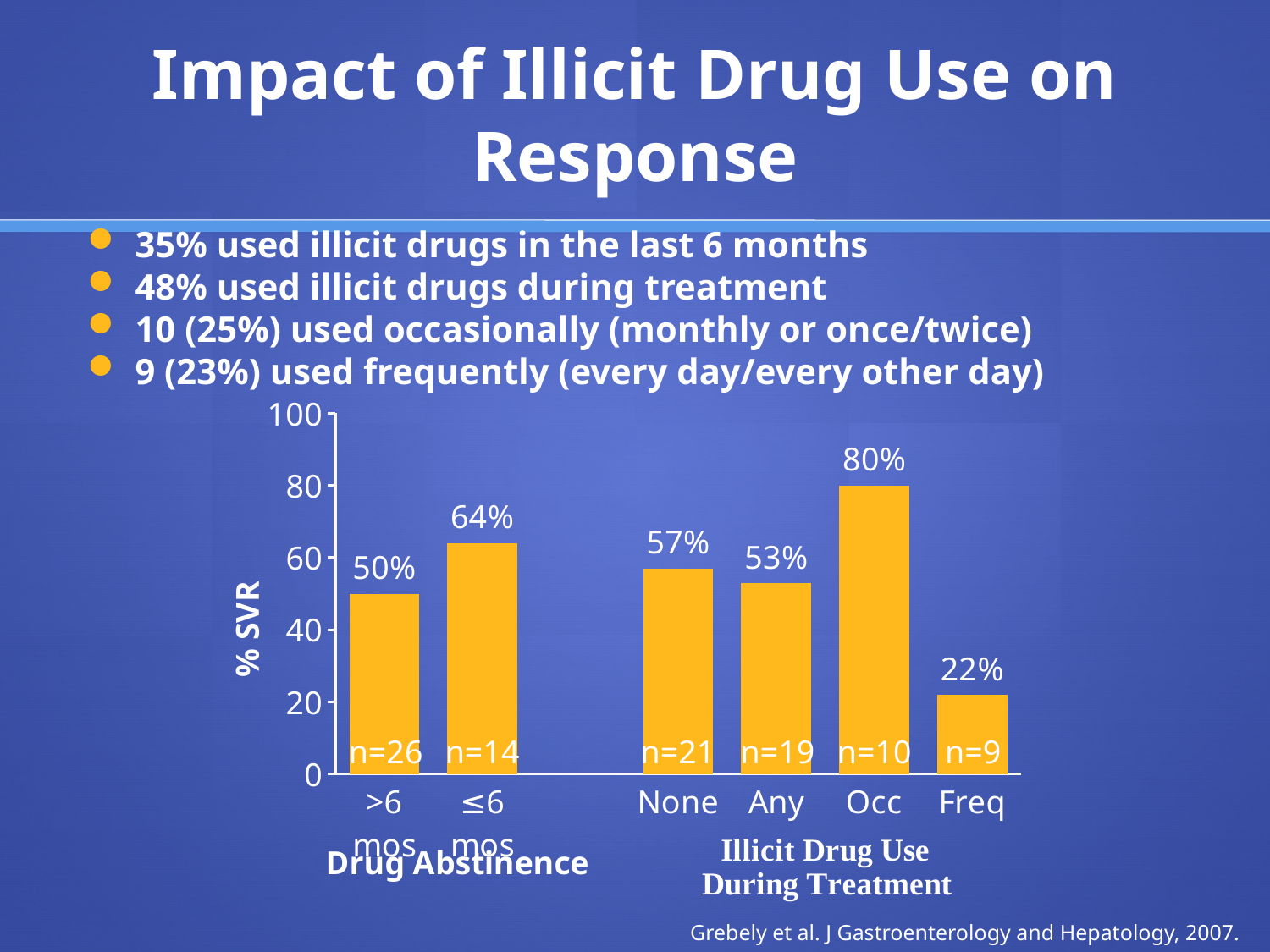
What is the % SVR for the >6 mos category? 50% What is the sample size (n) for the Any category? n=19 What is the % SVR for the None category? 57% How many bars are shown in the chart? 6 What kind of chart is shown on the slide? bar chart Which has a higher % SVR, None or Any? None Is the value for Freq greater or less than 40? less What is the difference in % SVR between the ≤6 mos and >6 mos categories? 14% Which category has the highest % SVR? Occ What is the % SVR for the Occ category? 80% What is the difference in % SVR between the Occ and Freq categories? 58% Which category has the lowest % SVR? Freq